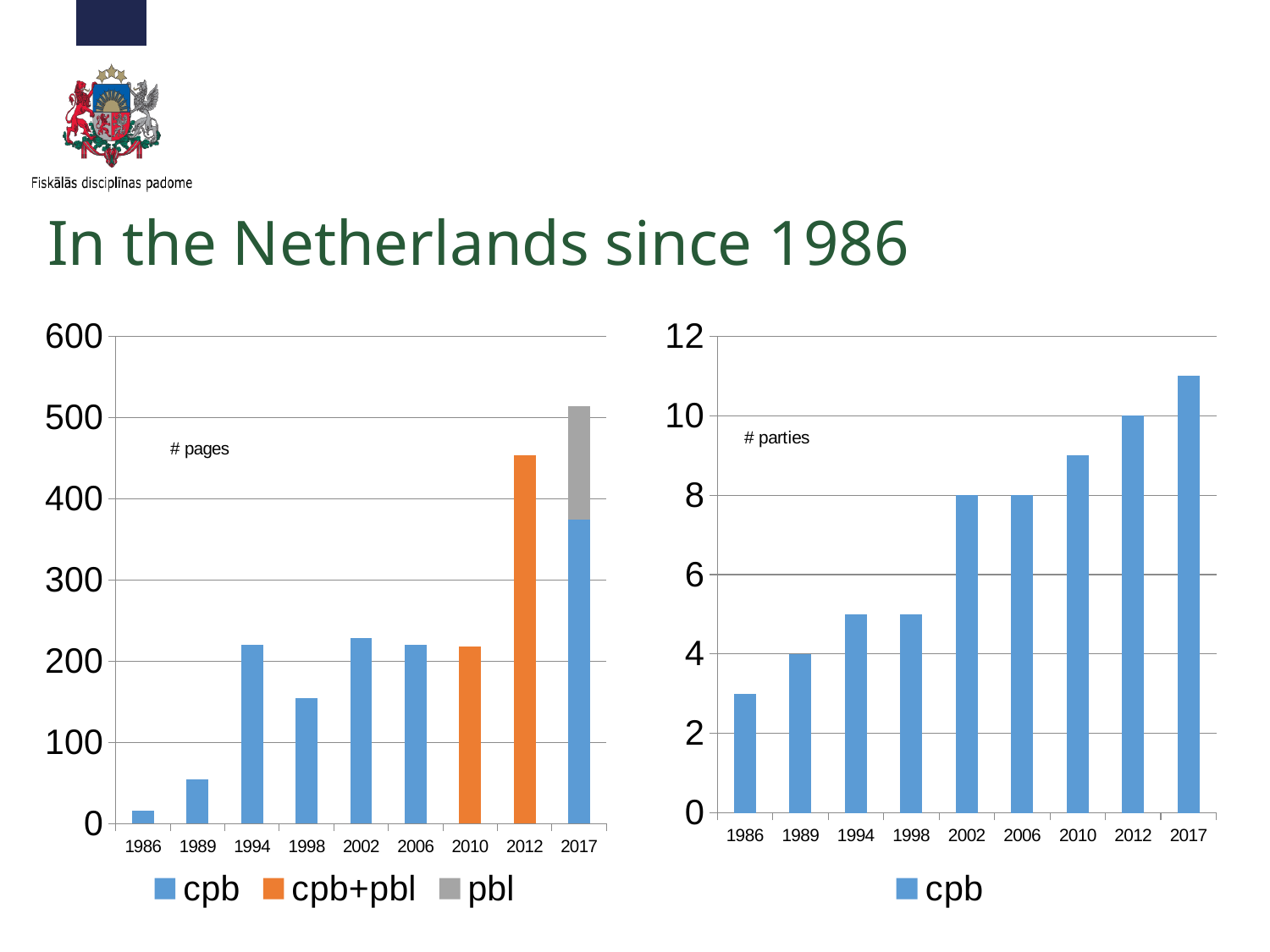
On the left chart (# pages), is the value for 2012 greater or less than 400? greater How many series does the legend of the left chart (# pages) list? 3 On the right chart (# parties), which year has the highest value? 2017 On the right chart (# parties), is the value for 2017 greater or less than 10? greater On the left chart (# pages), is the value for 1986 greater or less than 100? less On the left chart (# pages), which year has the tallest bar? 2017 On the right chart (# parties), what is the value for 2012? 10 On the right chart (# parties), do the values generally rise or fall from 1986 to 2017? rise How many years are shown on the x axis of the right chart (# parties)? 9 On the right chart (# parties), what is the value for 2002? 8 On the right chart (# parties), what is the value for 1989? 4 On the right chart (# parties), which year has the lowest value? 1986